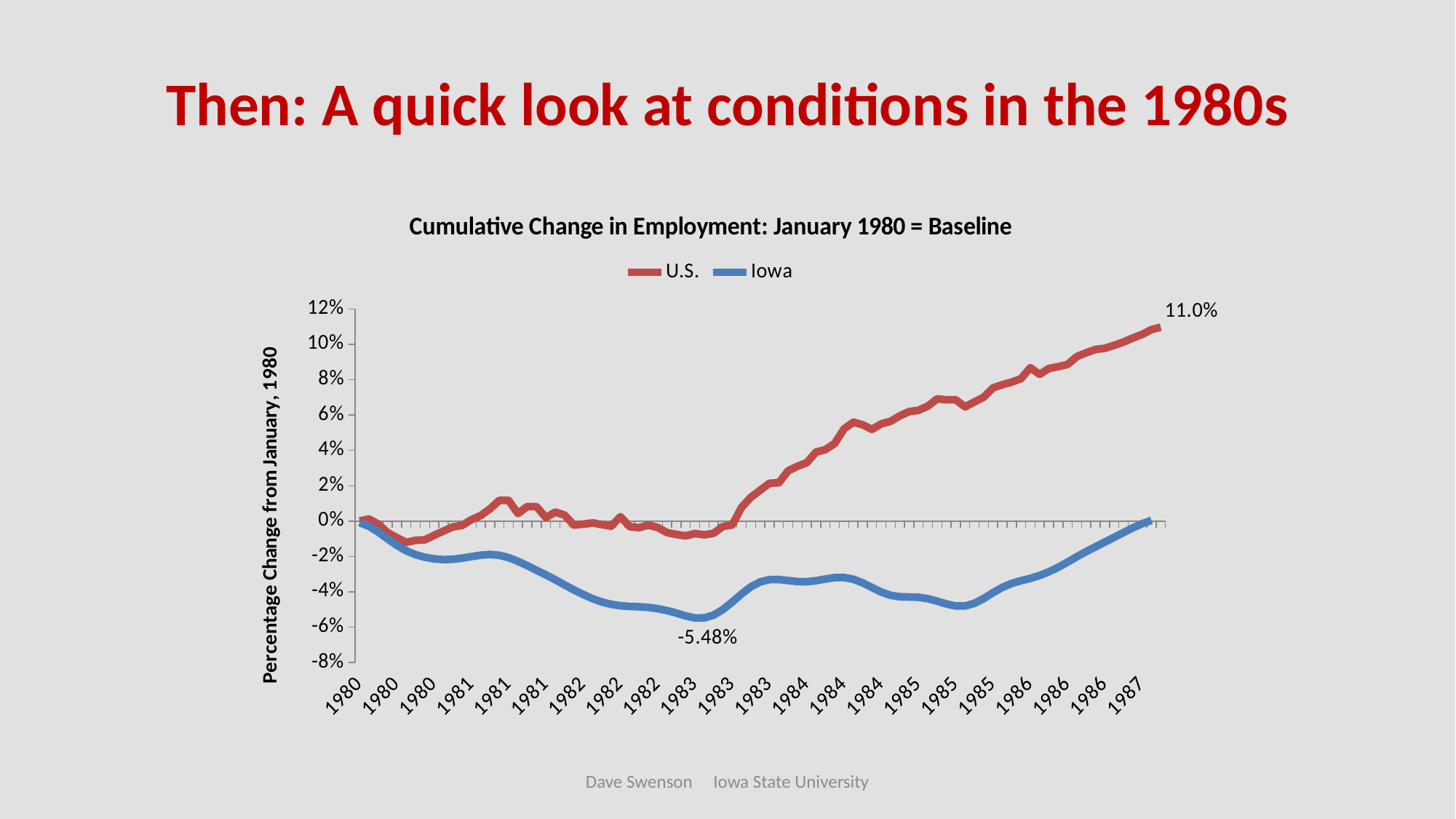
Which series reaches the highest value on the chart? U.S. Which series has the lowest value on the chart? Iowa At the end of the chart in 1987, which series is higher, U.S. or Iowa? U.S. How many series does the legend list? 2 Does the U.S. line rise or fall from 1983 to 1987? Rises What kind of chart is shown on the slide? Line chart Is the Iowa value at the end of 1987 greater or less than -2%? greater What is the difference between the labelled U.S. value of 11.0% and the labelled Iowa value of -5.48%? 16.48 percentage points What is the title of the chart? Cumulative Change in Employment: January 1980 = Baseline What are the two series named in the legend? U.S. and Iowa What is the lowest value labelled on the Iowa line? -5.48% What value is labelled at the end of the U.S. line in 1987? 11.0%